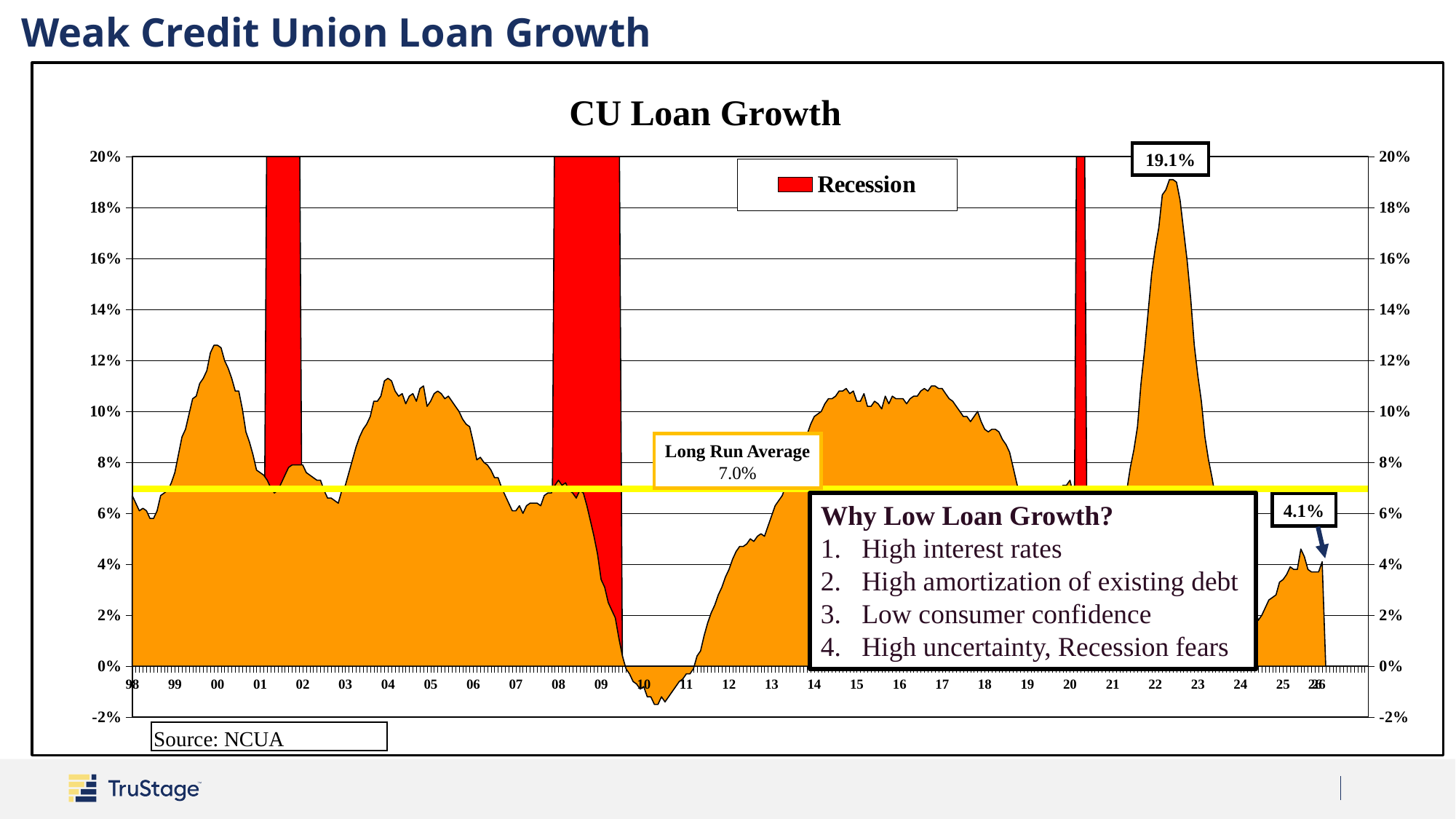
What is the title of the chart? CU Loan Growth What is the most recent loan growth value labeled on the chart? 4.1% Is the loan growth value around 2016 greater or less than 10%? greater Between the 2022 peak and 2024, do the loan growth values rise or fall? fall How much higher is the labeled peak of 19.1% than the Long Run Average of 7.0%? 12.1% Which is larger, the latest labeled value of 4.1% or the Long Run Average? the Long Run Average (7.0%) What is the peak loan growth value labeled on the chart around 2022? 19.1% What is the difference between the labeled peak of 19.1% and the latest labeled value of 4.1%? 15.0% What kind of chart is used to show CU loan growth? area chart What is the Long Run Average value shown on the chart? 7.0% What do the red shaded bands on the chart represent according to the legend? Recession Is the lowest value of loan growth around 2010 greater or less than 0%? less